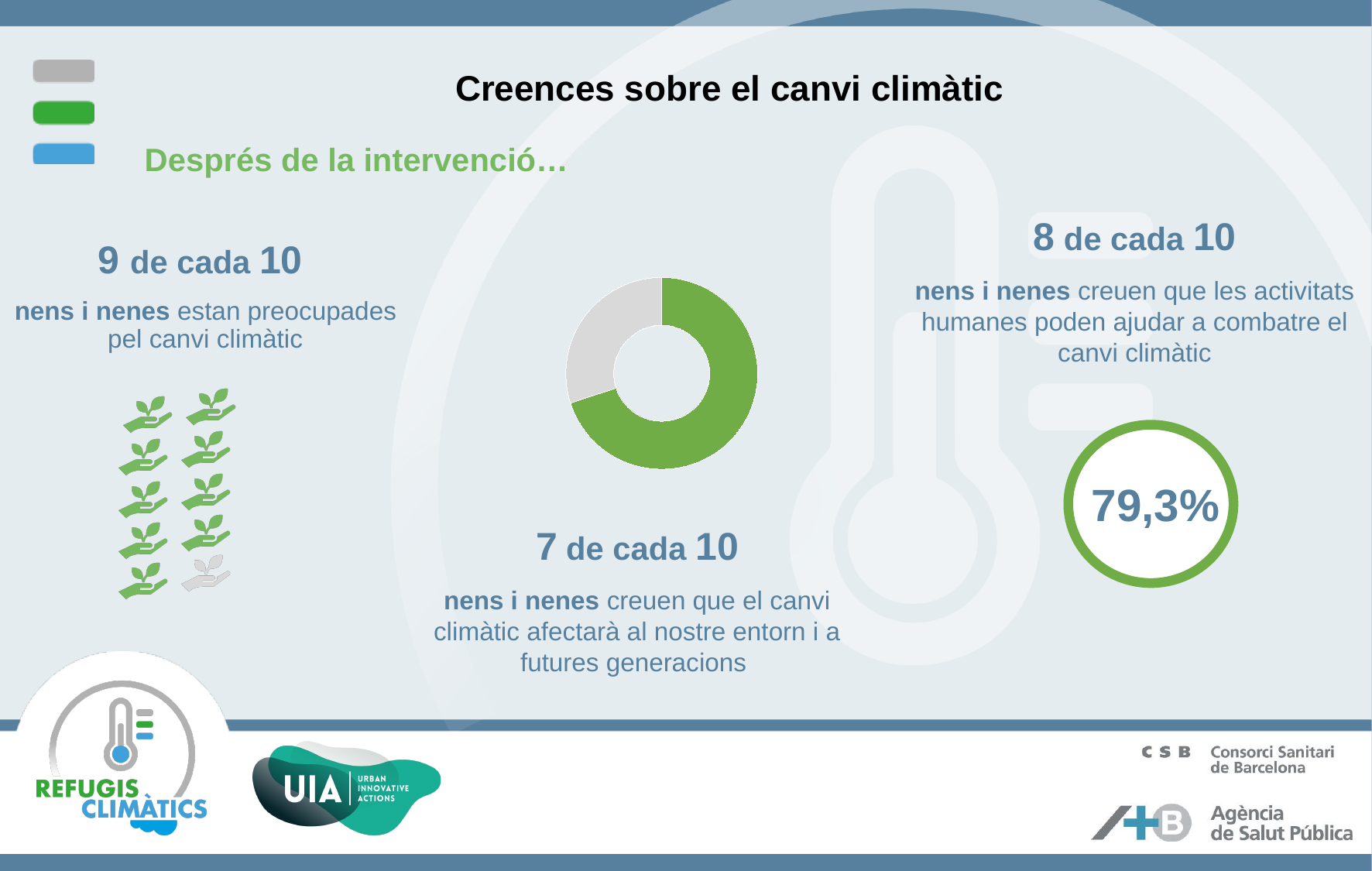
In the donut chart in the centre of the slide, which slice is larger, the green one or the grey one? green In the donut chart in the centre of the slide, is the green slice's share greater or less than 50%? greater What percentage is printed inside the green ring on the right of the slide? 79,3% What two colours are used for the slices of the donut chart in the centre of the slide? green and grey In the donut chart in the centre of the slide, is the grey slice's share greater or less than 50%? less How many slices does the donut chart in the centre of the slide have? 2 What is the title of the slide containing the donut chart? Creences sobre el canvi climàtic What kind of chart is shown in the centre of the slide? pie chart (donut)